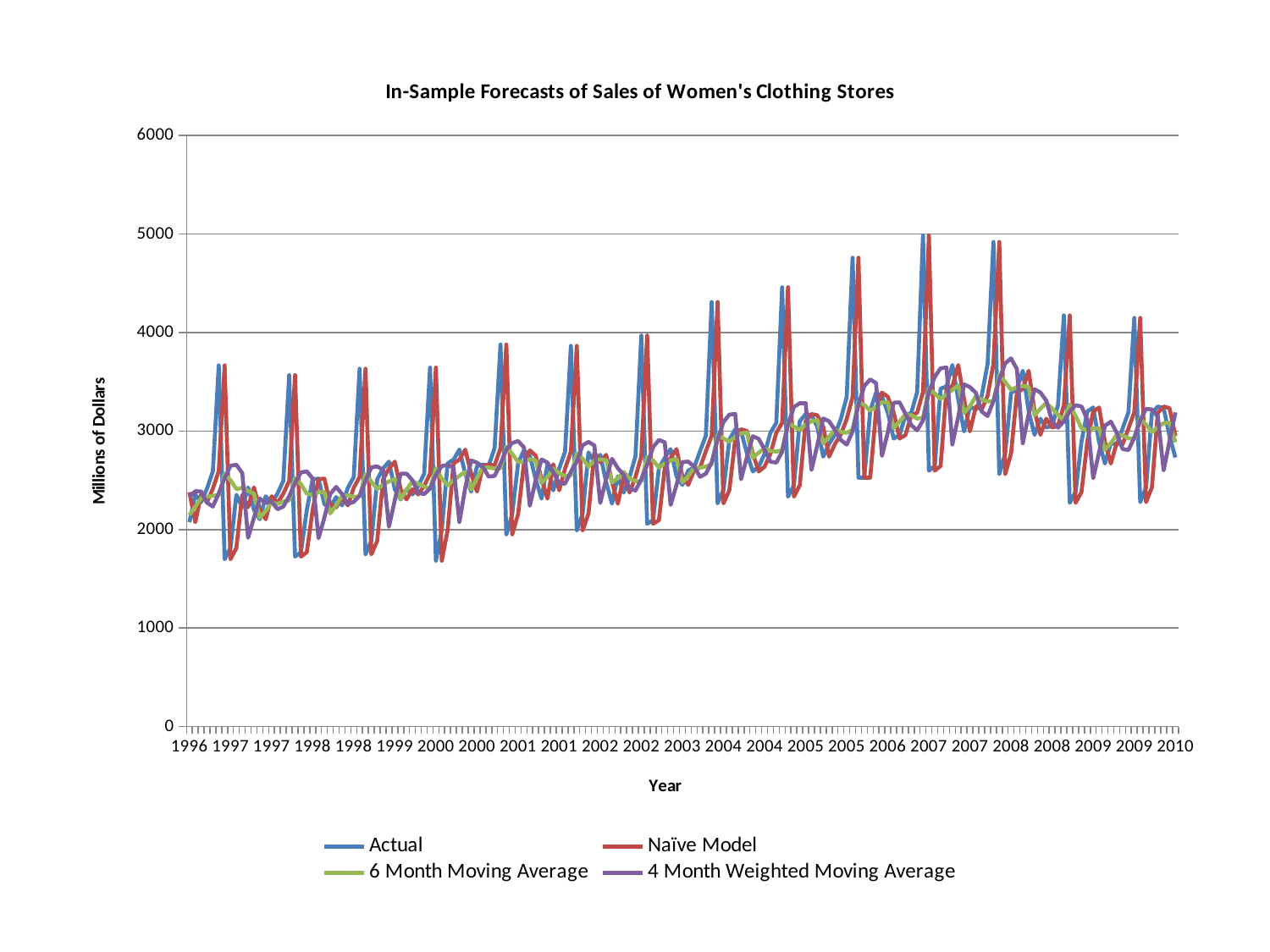
Is the highest peak of the Actual series, around 2007, greater or less than 4000? greater Do the seasonal peaks of the Actual series generally rise or fall from 1996 to 2007? rise What kind of chart is shown on the slide? Line chart Is the 6 Month Moving Average value at the end of the series in 2010 greater or less than 2000? greater Is the lowest trough of the Actual series, around 2000, greater or less than 2000? less Which series is plotted in purple? 4 Month Weighted Moving Average How many series does the legend list? 4 What is the title of the chart? In-Sample Forecasts of Sales of Women's Clothing Stores Which is higher: the Actual peak around 2007 or the Actual peak around 1997? The peak around 2007 What is the label of the vertical axis? Millions of Dollars